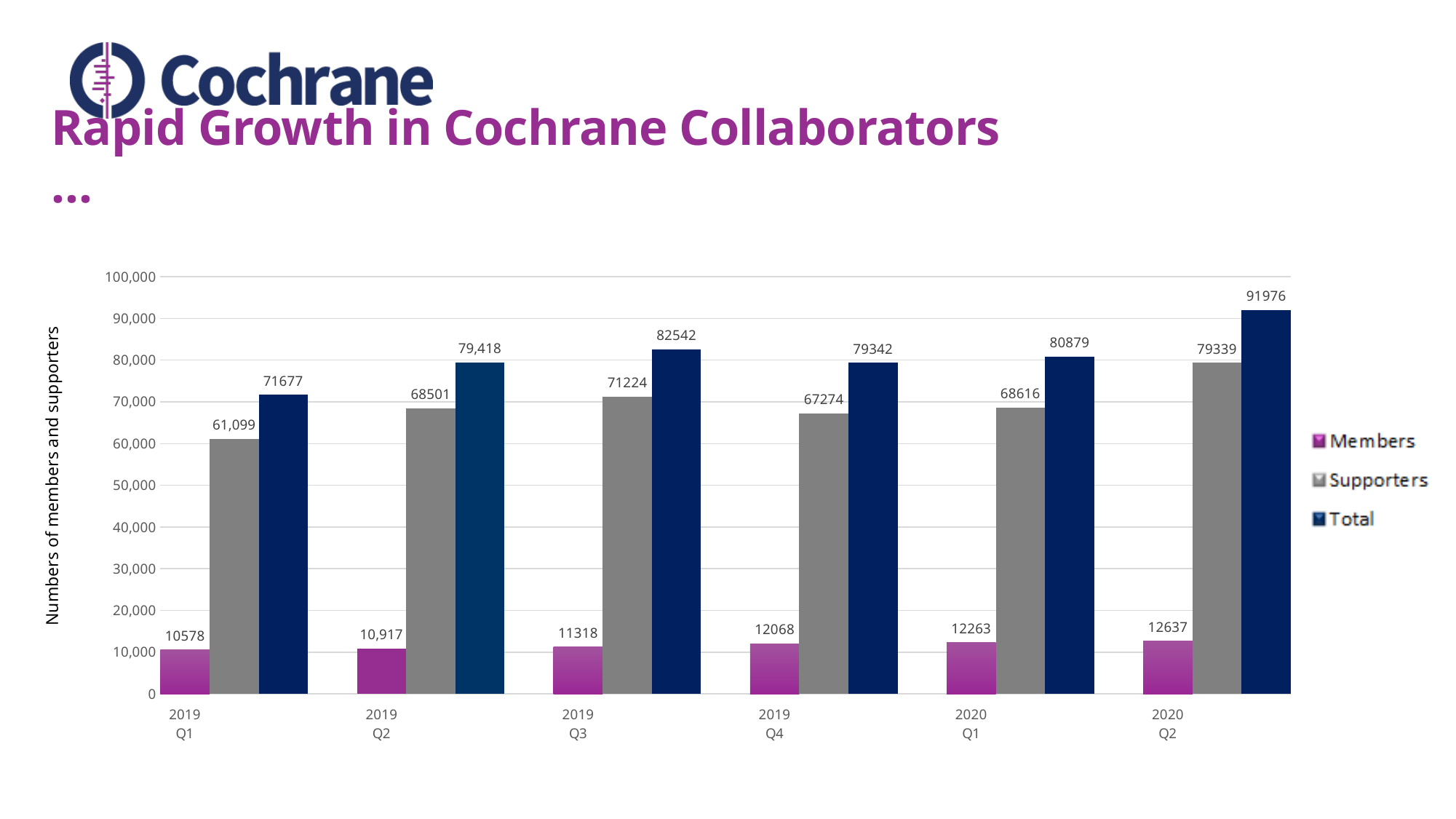
What kind of chart is shown on the slide? bar chart Do the Members values rise or fall from 2019 Q1 to 2020 Q2? rise What is the title of the vertical axis? Numbers of members and supporters What is the value for Members in 2019 Q1? 10578 What is the Total value for 2019 Q3? 82542 In which quarter is the Total value highest? 2020 Q2 What is the difference between the Total value in 2020 Q2 and the Total value in 2020 Q1? 11097 How many series does the legend list? 3 Which quarter has the larger Supporters value, 2019 Q3 or 2019 Q4? 2019 Q3 In which quarter is the Supporters value lowest? 2019 Q1 What is the value for Supporters in 2020 Q2? 79339 How many quarters are shown on the x axis? 6